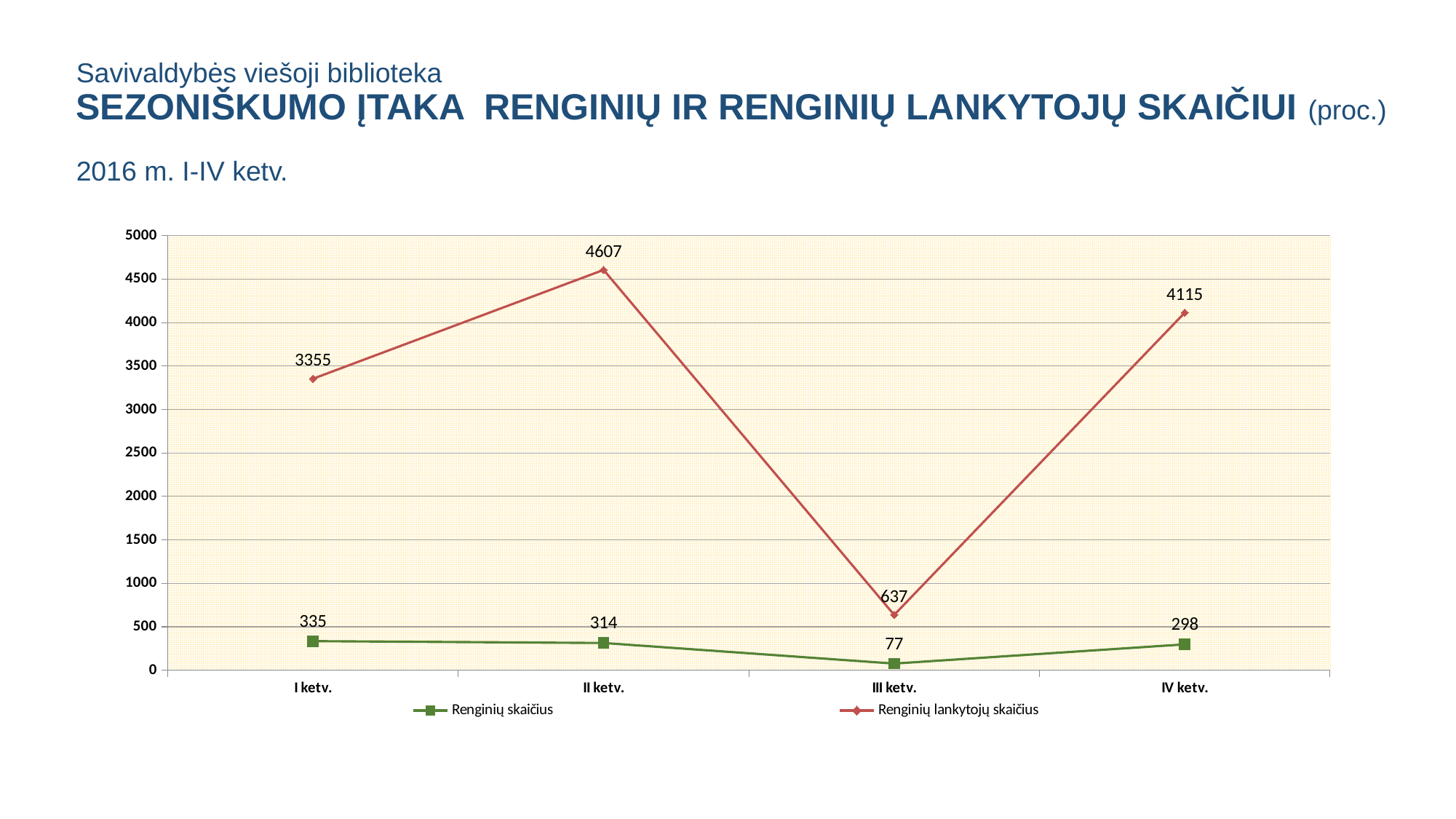
What is the value of Renginių lankytojų skaičius for II ketv.? 4607 How many quarters are shown on the x axis? 4 Is the value of Renginių lankytojų skaičius for I ketv. greater or less than 3000? greater What is the difference between Renginių skaičius in I ketv. and IV ketv.? 37 What is the value of Renginių lankytojų skaičius for IV ketv.? 4115 In which quarter is Renginių skaičius lowest? III ketv. Which is larger: Renginių lankytojų skaičius in I ketv. or in IV ketv.? IV ketv. How many series does the legend list? 2 What is the difference between Renginių lankytojų skaičius in II ketv. and III ketv.? 3970 In which quarter is Renginių lankytojų skaičius highest? II ketv. What kind of chart is shown on the slide? line chart What is the value of Renginių skaičius for III ketv.? 77